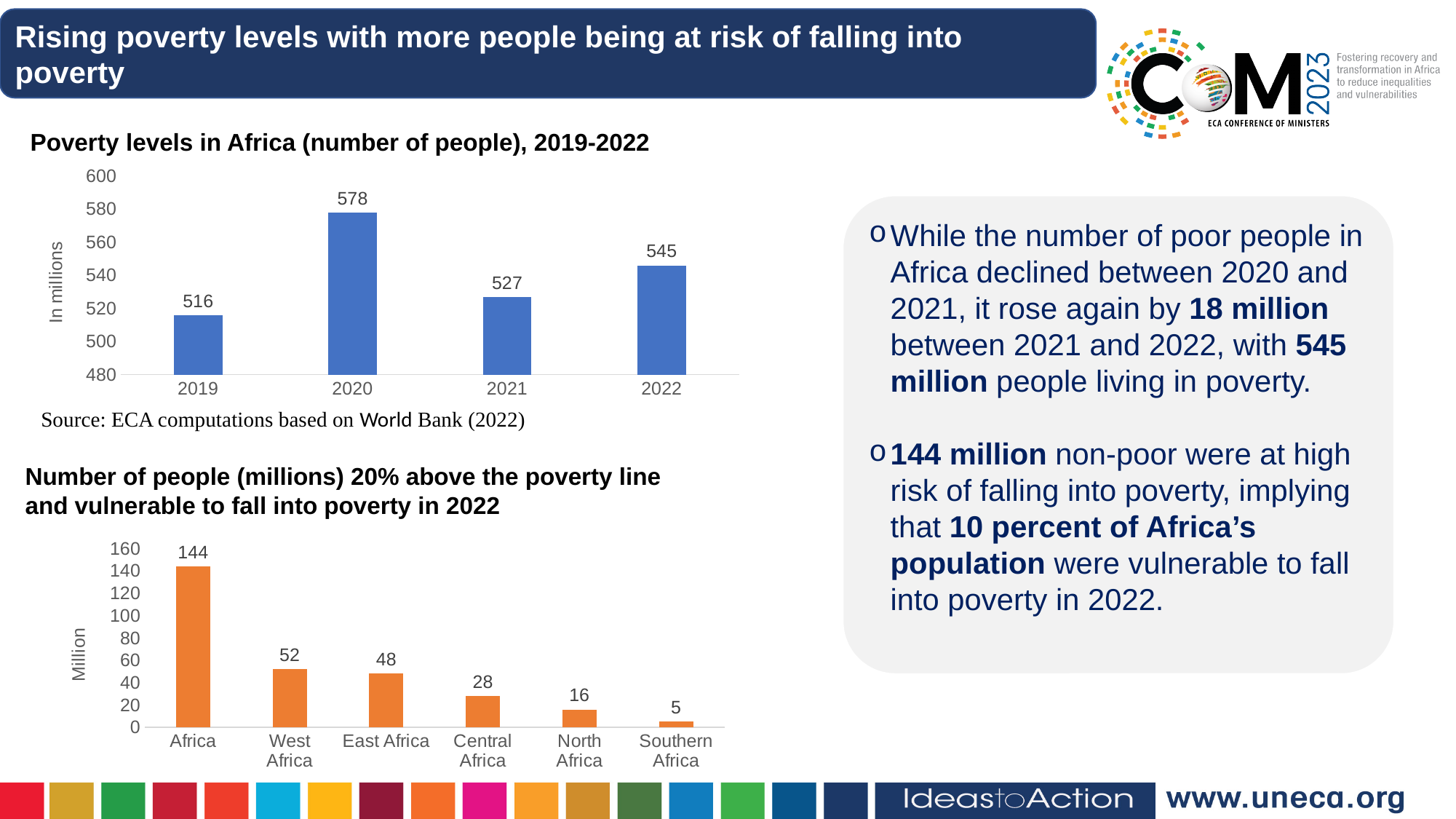
In the 'Number of people (millions) 20% above the poverty line and vulnerable to fall into poverty in 2022' chart, which is larger, West Africa or Central Africa? West Africa In the 'Number of people (millions) 20% above the poverty line and vulnerable to fall into poverty in 2022' chart, what is the value for East Africa? 48 In the 'Poverty levels in Africa (number of people), 2019-2022' chart, which year has the lowest value? 2019 In the 'Poverty levels in Africa (number of people), 2019-2022' chart, what is the difference between the 2022 and 2021 values? 18 In the 'Number of people (millions) 20% above the poverty line and vulnerable to fall into poverty in 2022' chart, what is the difference between West Africa and North Africa? 36 In the 'Number of people (millions) 20% above the poverty line and vulnerable to fall into poverty in 2022' chart, which region has the lowest value? Southern Africa What type of chart is the 'Number of people (millions) 20% above the poverty line and vulnerable to fall into poverty in 2022' chart? Bar chart In the 'Poverty levels in Africa (number of people), 2019-2022' chart, what is the value for 2020? 578 In the 'Poverty levels in Africa (number of people), 2019-2022' chart, is the value for 2021 greater or less than 540? less In the 'Poverty levels in Africa (number of people), 2019-2022' chart, how many years are plotted? 4 In the 'Poverty levels in Africa (number of people), 2019-2022' chart, what is the y-axis label? In millions In the 'Number of people (millions) 20% above the poverty line and vulnerable to fall into poverty in 2022' chart, how many categories are shown? 6